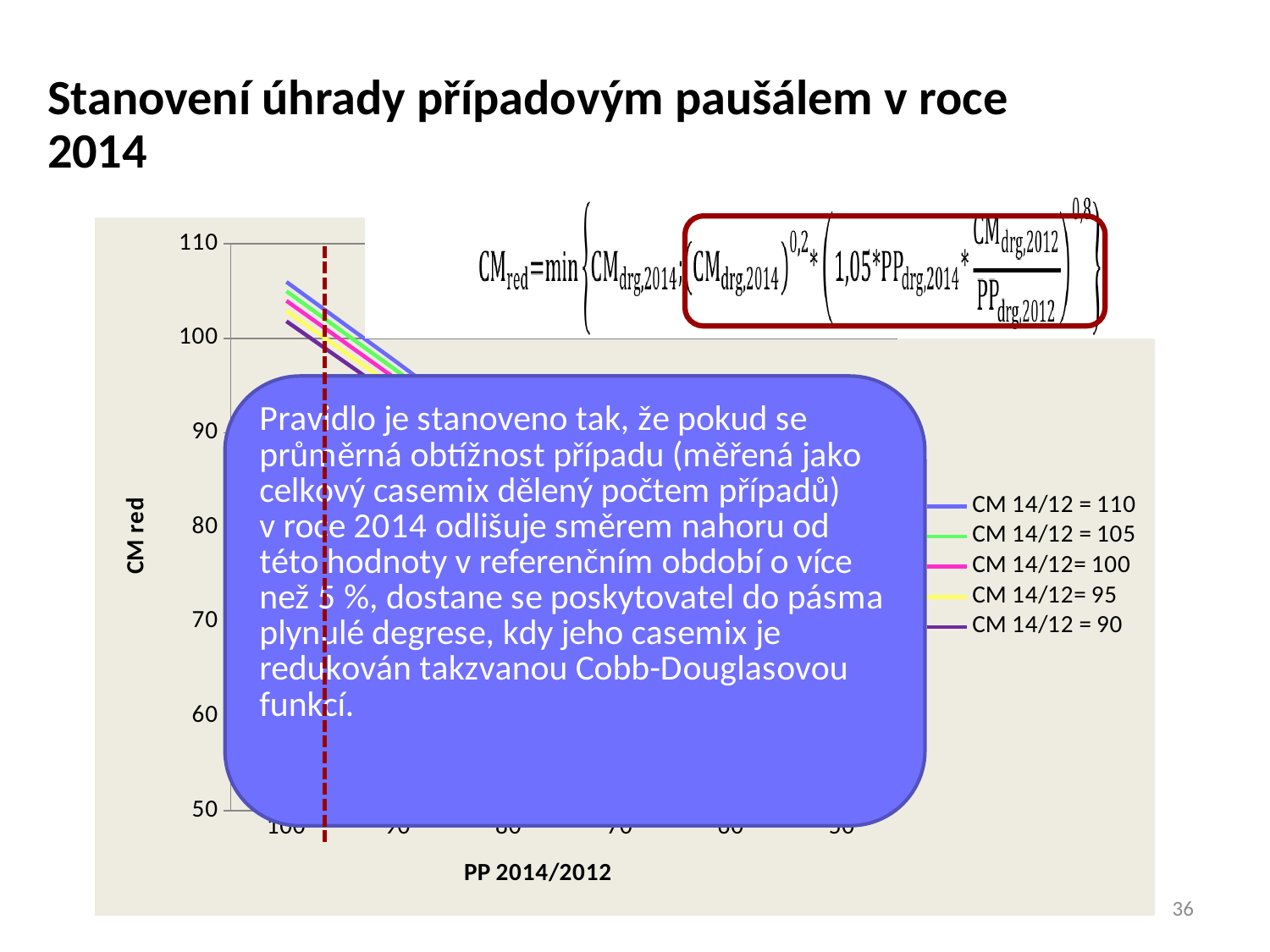
Is the value of the CM 14/12 = 110 line at PP 2014/2012 = 100 greater or less than 100? greater At the left edge of the chart, which line is higher: CM 14/12 = 110 or CM 14/12 = 90? CM 14/12 = 110 Which series is plotted as the lowest line at the left edge of the chart? CM 14/12 = 90 What is the lowest tick value shown on the vertical axis? 50 Do the plotted lines rise or fall as they move from left to right along the x axis? fall Is the value of the CM 14/12 = 110 line at PP 2014/2012 = 100 greater or less than 110? less What is the label of the chart's vertical axis? CM red Which series is plotted as the topmost line at the left edge of the chart? CM 14/12 = 110 What kind of chart is shown on the slide? line chart What is the label of the chart's horizontal axis? PP 2014/2012 How many series does the chart's legend list? 5 What is the highest tick value shown on the vertical axis? 110